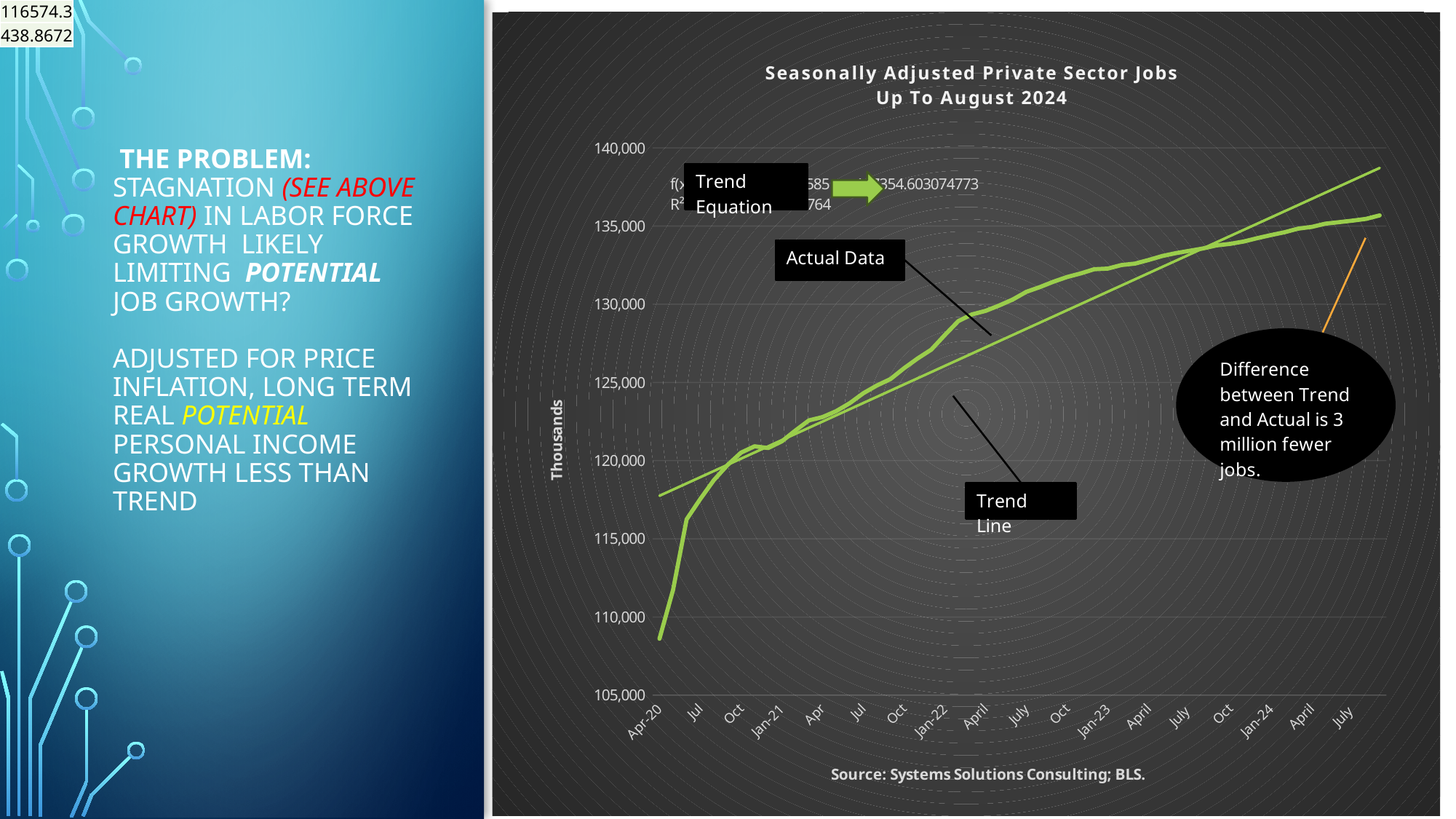
Does the Actual Data line generally rise or fall from Apr-20 to July 2024? rise How many labels are shown on the x axis of the chart? 18 Is the Actual Data value at Jan-21 greater or less than 125,000? less What kind of chart is shown on the slide? line chart Is the Actual Data value at Apr-20 greater or less than 110,000? less At the last point on the chart (July 2024), which is higher: the Trend Line or the Actual Data? Trend Line What is the title of the chart? Seasonally Adjusted Private Sector Jobs Up To August 2024 What is the label on the vertical axis of the chart? Thousands Is the Actual Data value at the last point (July 2024) greater or less than 130,000? greater What is the highest tick value shown on the vertical axis? 140,000 At April 2022, which is higher: the Actual Data or the Trend Line? Actual Data